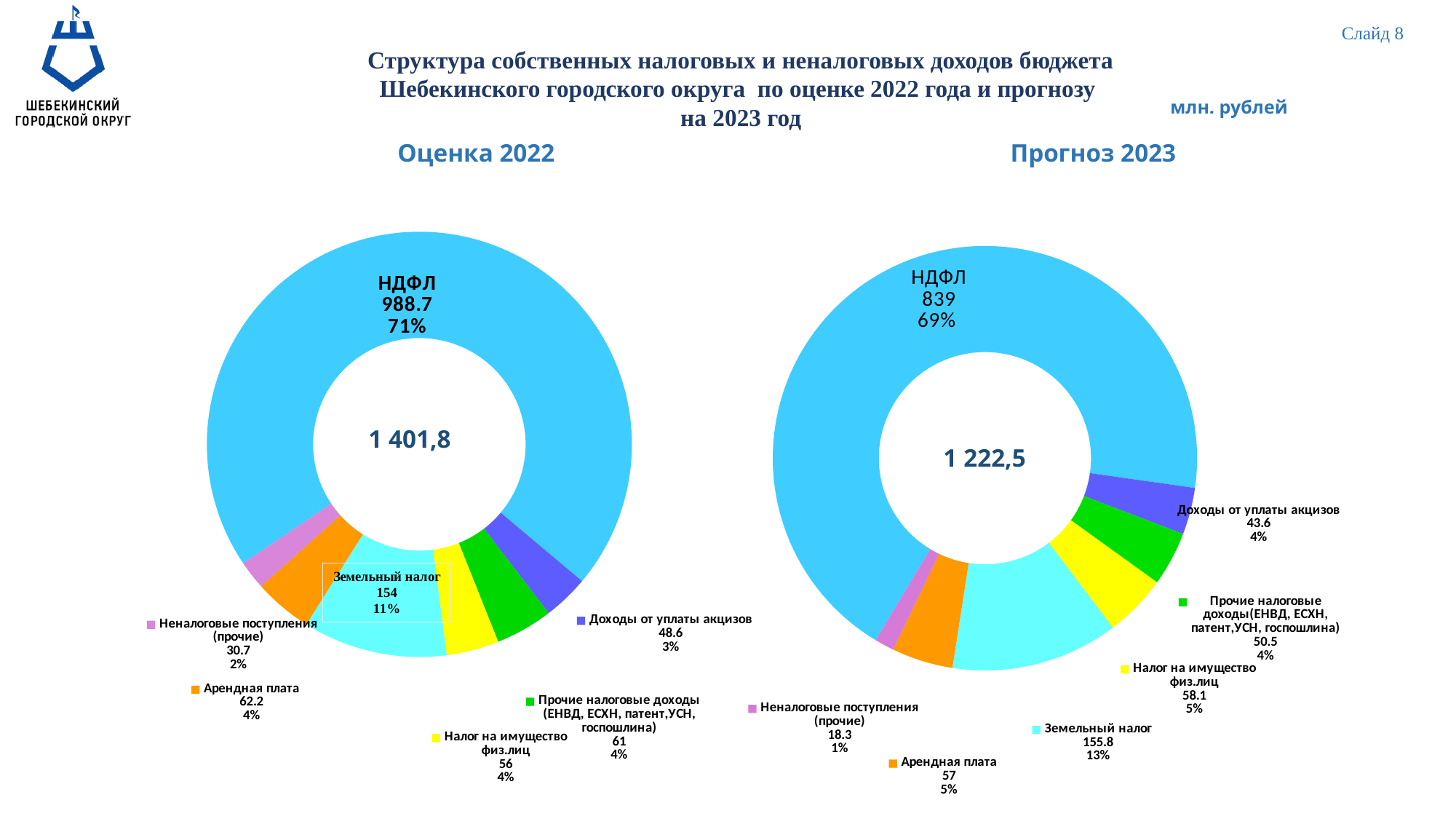
How many categories are shown in the 'Оценка 2022' chart? 7 What total is shown in the centre of the 'Оценка 2022' chart? 1 401,8 In the 'Прогноз 2023' chart, what share of the pie does НДФЛ take? 69% What kind of chart is used for 'Прогноз 2023'? Doughnut (pie) chart In the 'Прогноз 2023' chart, which category has the highest value? НДФЛ In the 'Прогноз 2023' chart, which is larger: Налог на имущество физ.лиц or Арендная плата? Налог на имущество физ.лиц What total is shown in the centre of the 'Прогноз 2023' chart? 1 222,5 In the 'Оценка 2022' chart, what is the value for НДФЛ? 988.7 In the 'Оценка 2022' chart, which category has the lowest value? Неналоговые поступления (прочие) In the 'Оценка 2022' chart, what is the difference between Арендная плата and Налог на имущество физ.лиц? 6.2 In the 'Прогноз 2023' chart, what is the value for Земельный налог? 155.8 In the 'Оценка 2022' chart, what share of the pie does Земельный налог take? 11%